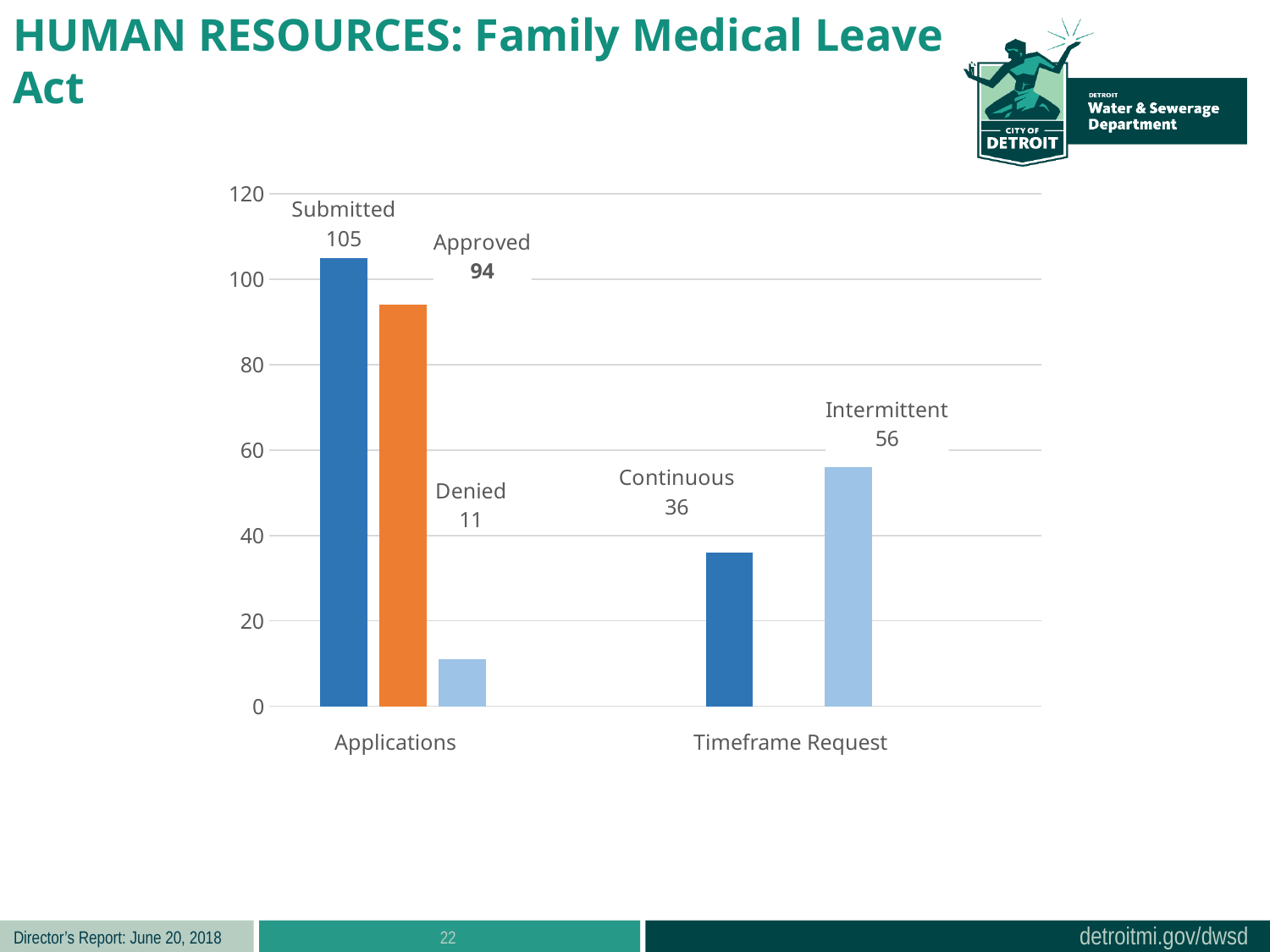
Which bar has the lowest value on the chart? Denied What is the difference between Submitted and Approved applications? 11 What is the value for Continuous timeframe requests? 36 How many category groups are shown on the x axis? 2 What is the value for Approved applications? 94 Which bar has the highest value on the chart? Submitted What is the value for Submitted applications? 105 What kind of chart is shown on the slide? Bar chart What is the value for Denied applications? 11 What is the difference between Intermittent and Continuous timeframe requests? 20 Which is larger, Continuous or Intermittent? Intermittent What is the value for Intermittent timeframe requests? 56